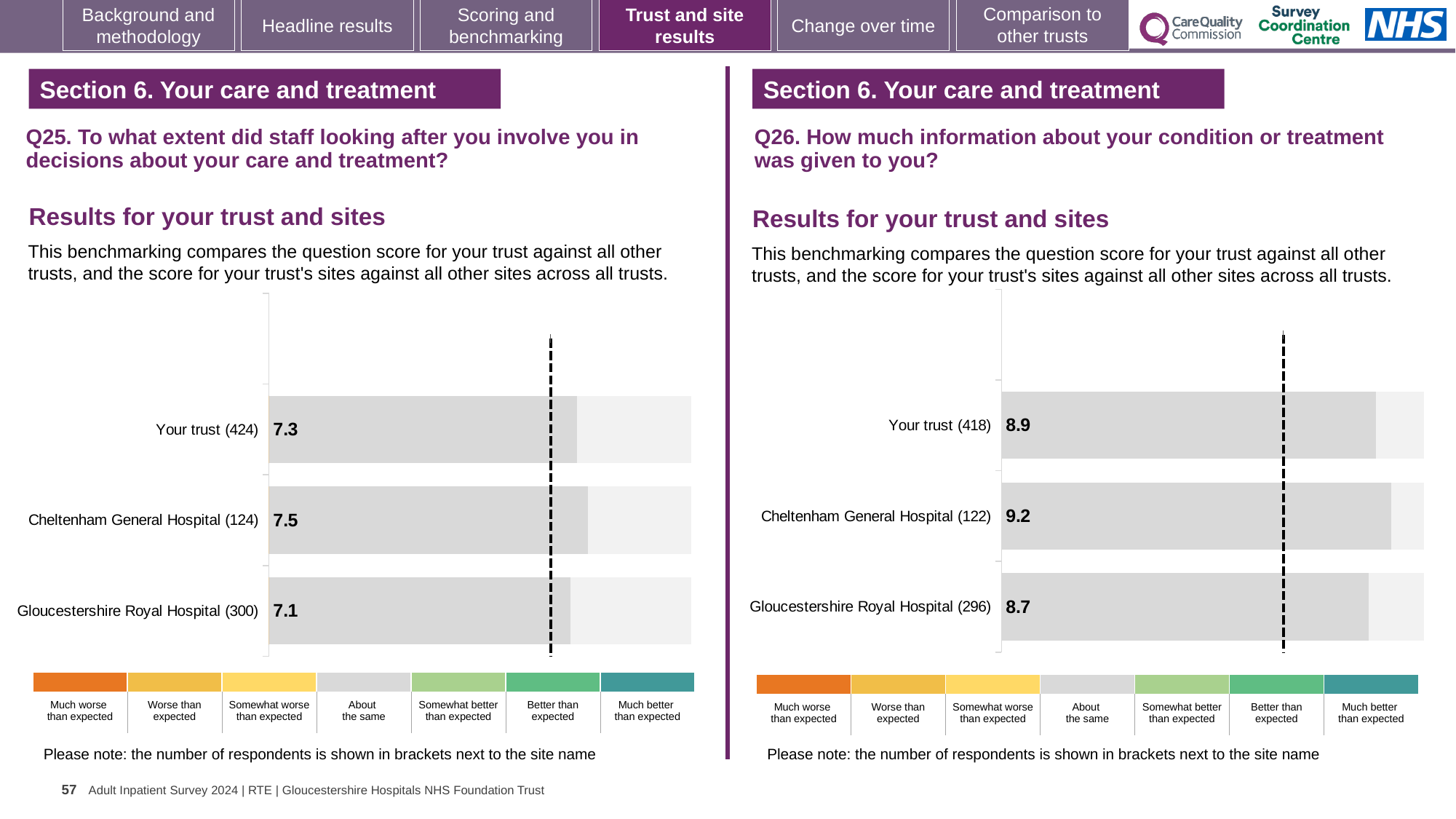
In the Q25 chart on the left, what is the difference between the scores for Cheltenham General Hospital and Gloucestershire Royal Hospital? 0.4 In the Q25 chart on the left, what is the score for Your trust? 7.3 In the Q25 chart on the left, which site or trust has the lowest score? Gloucestershire Royal Hospital In the Q25 chart on the left, what is the score for Cheltenham General Hospital? 7.5 In the Q26 chart on the right, what is the difference between the scores for Cheltenham General Hospital and Your trust? 0.3 How many bars are plotted in the Q25 chart on the left? 3 What type of chart is used for the Q26 results on the right? Bar chart In the Q26 chart on the right, how many respondents are shown in brackets for Your trust? 418 In the Q25 chart on the left, how many respondents are shown in brackets for Gloucestershire Royal Hospital? 300 In the Q26 chart on the right, which has the larger score: Your trust or Gloucestershire Royal Hospital? Your trust In the Q26 chart on the right, which site or trust has the highest score? Cheltenham General Hospital In the Q26 chart on the right, what is the score for Gloucestershire Royal Hospital? 8.7